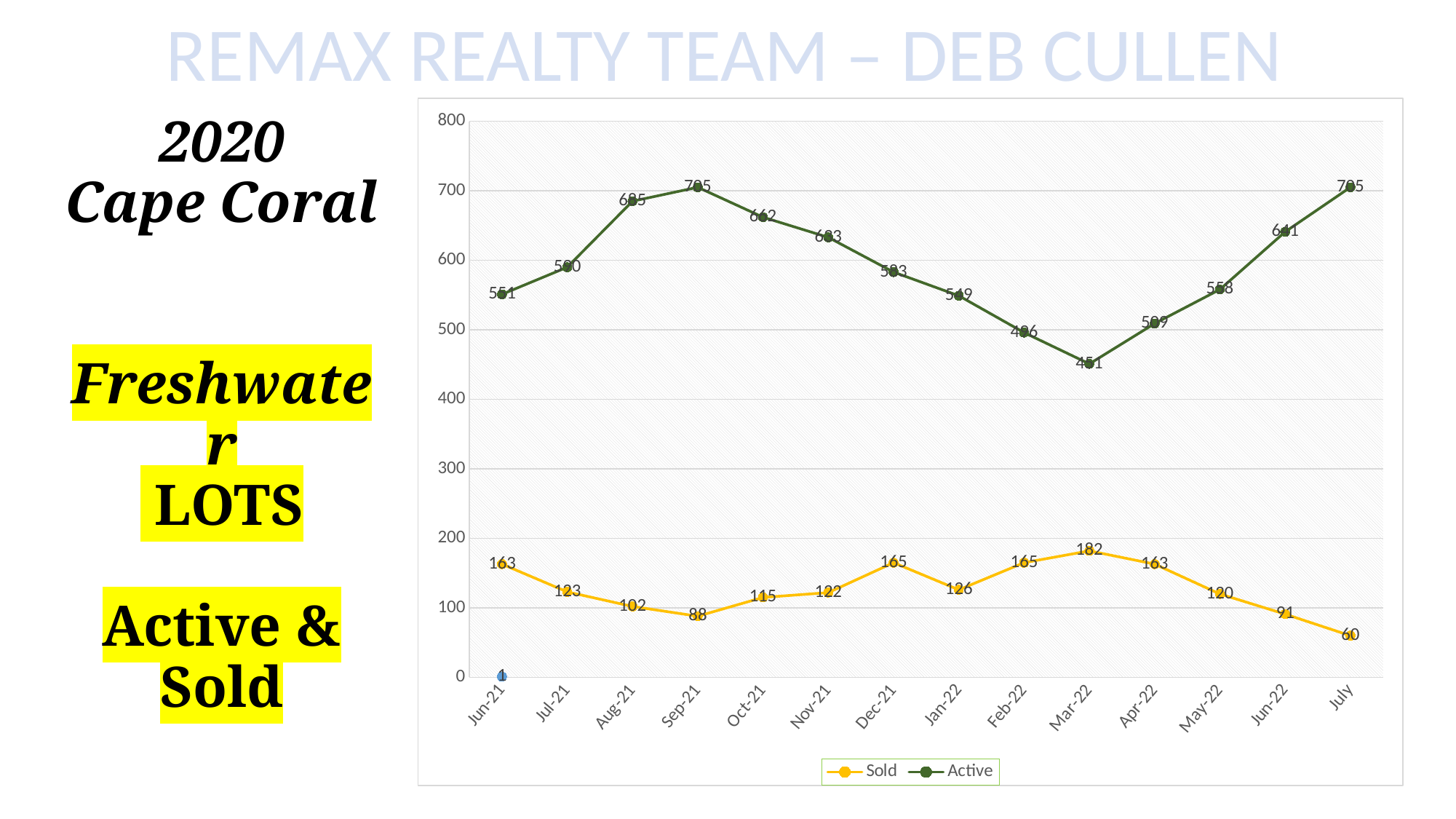
In which month is the Sold series lowest? July Which is larger, the Active value for Sep-21 or the Active value for Jun-21? Sep-21 What is the difference between the Sold value for Jun-21 and the Sold value for July? 103 What is the Active value for Oct-21? 662 What is the Sold value for Mar-22? 182 How many series does the legend list? 2 What kind of chart is shown on the slide? line chart What is the Sold value for Sep-21? 88 How many months are plotted along the x axis? 14 In which month is the Sold series highest? Mar-22 Is the Active value for Mar-22 greater or less than 500? less Does the Active series rise or fall from Mar-22 to July? rise